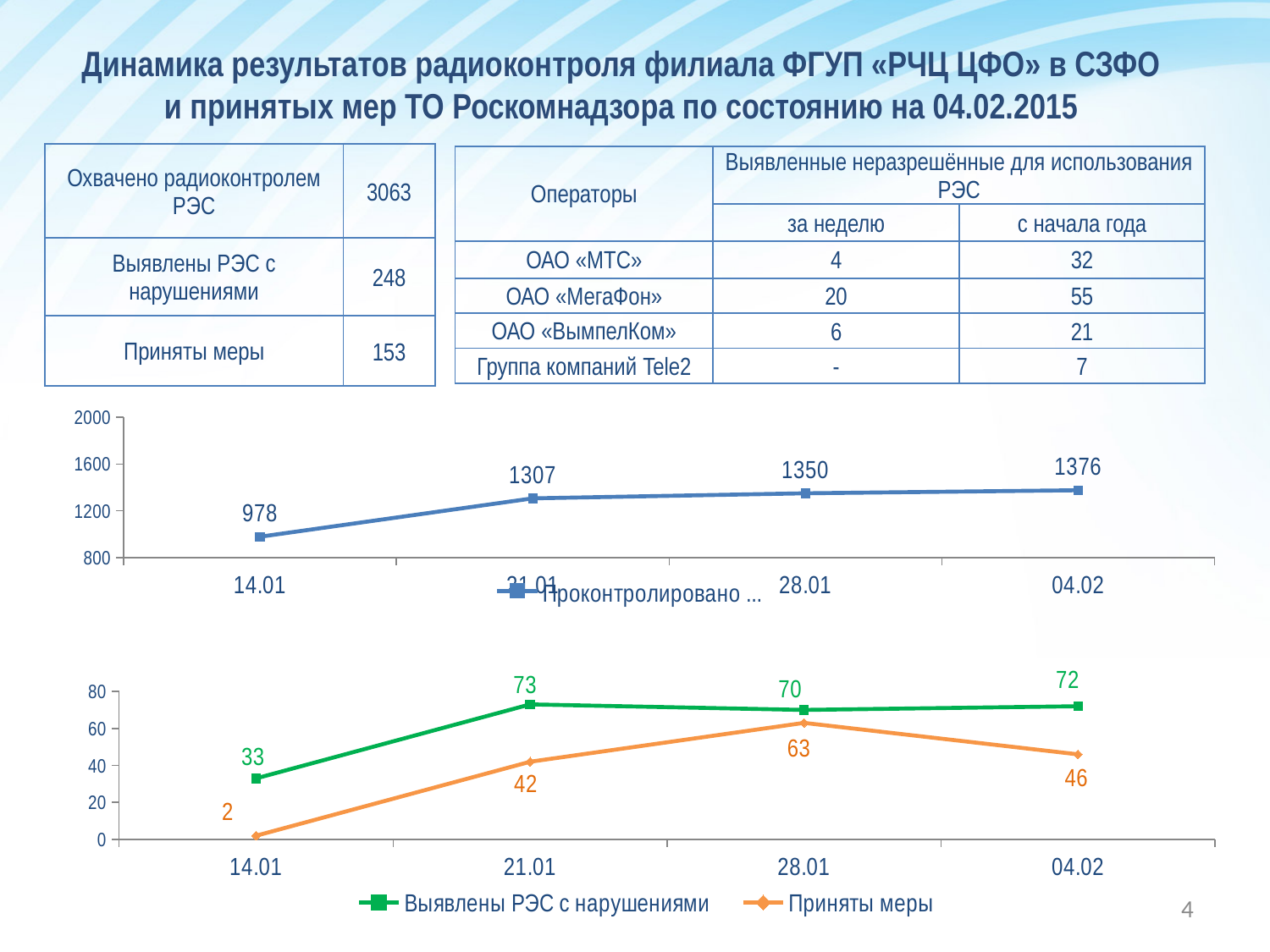
In the upper chart, what is the difference between the values for 21.01 and 14.01? 329 In the upper chart, do the values rise or fall from 14.01 to 04.02? rise In the lower chart, which is larger on 04.02: Выявлены РЭС с нарушениями or Приняты меры? Выявлены РЭС с нарушениями In the upper chart, what is the value for 14.01? 978 What kind of chart is the lower chart? line chart In the lower chart, what is the value of Выявлены РЭС с нарушениями for 21.01? 73 How many series does the legend of the lower chart list? 2 In the lower chart, what is the value of Приняты меры for 28.01? 63 In the lower chart, what is the difference between Выявлены РЭС с нарушениями and Приняты меры on 14.01? 31 In the lower chart, on which date is Приняты меры highest? 28.01 In the upper chart, which date has the lowest value? 14.01 In the upper chart, what is the value for 04.02? 1376